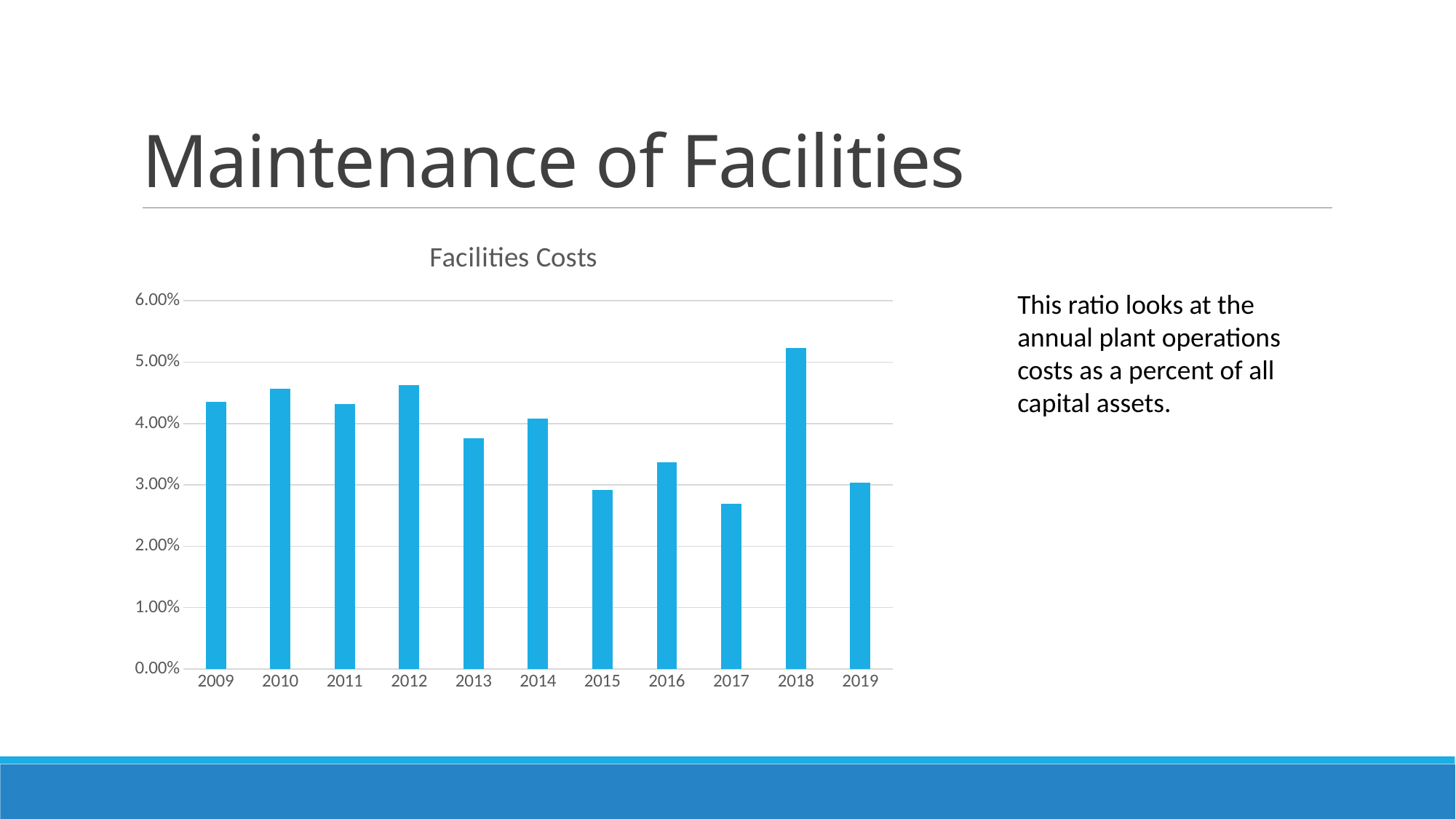
Which year has a higher value, 2012 or 2011? 2012 Which year has a higher value, 2013 or 2016? 2013 What type of chart is shown on the slide? Bar chart Is the value for 2014 greater or less than 4.00%? greater What is the title of the chart? Facilities Costs How many years are shown on the x axis of the chart? 11 Which year has the lowest facilities cost ratio? 2017 Is the value for 2017 greater or less than 3.00%? less Is the value for 2013 greater or less than 4.00%? less Which year has the highest facilities cost ratio? 2018